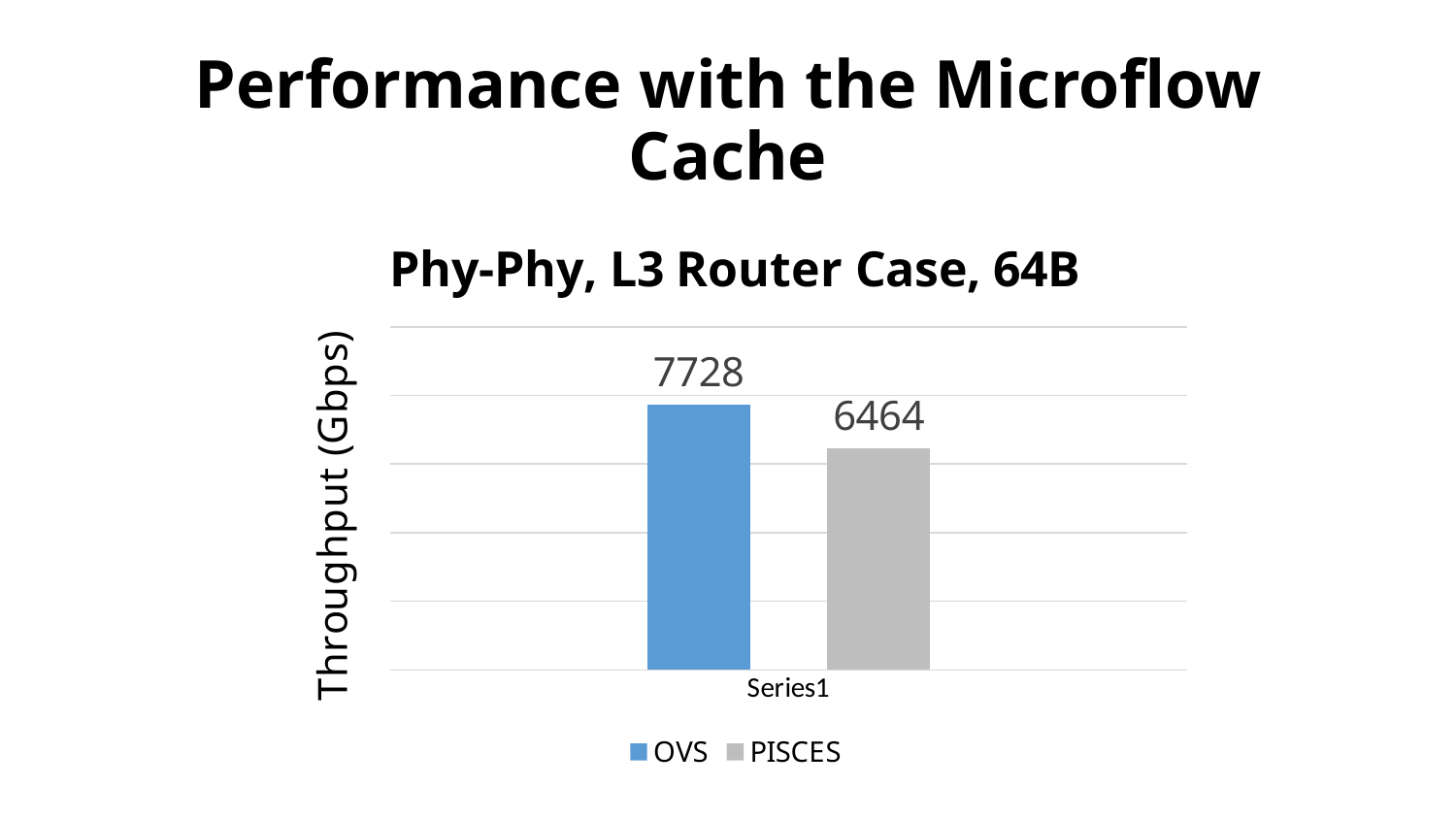
What kind of chart is shown on the slide? Bar chart What is the throughput value for PISCES? 6464 What is the label on the vertical axis of the chart? Throughput (Gbps) Which series has the highest throughput? OVS What is the title of the chart? Phy-Phy, L3 Router Case, 64B What is the category label shown on the x axis? Series1 What is the difference between the OVS and PISCES throughput values? 1264 What is the throughput value for OVS? 7728 Which series has the higher throughput, OVS or PISCES? OVS Which series has the lowest throughput? PISCES How many series does the legend list? 2